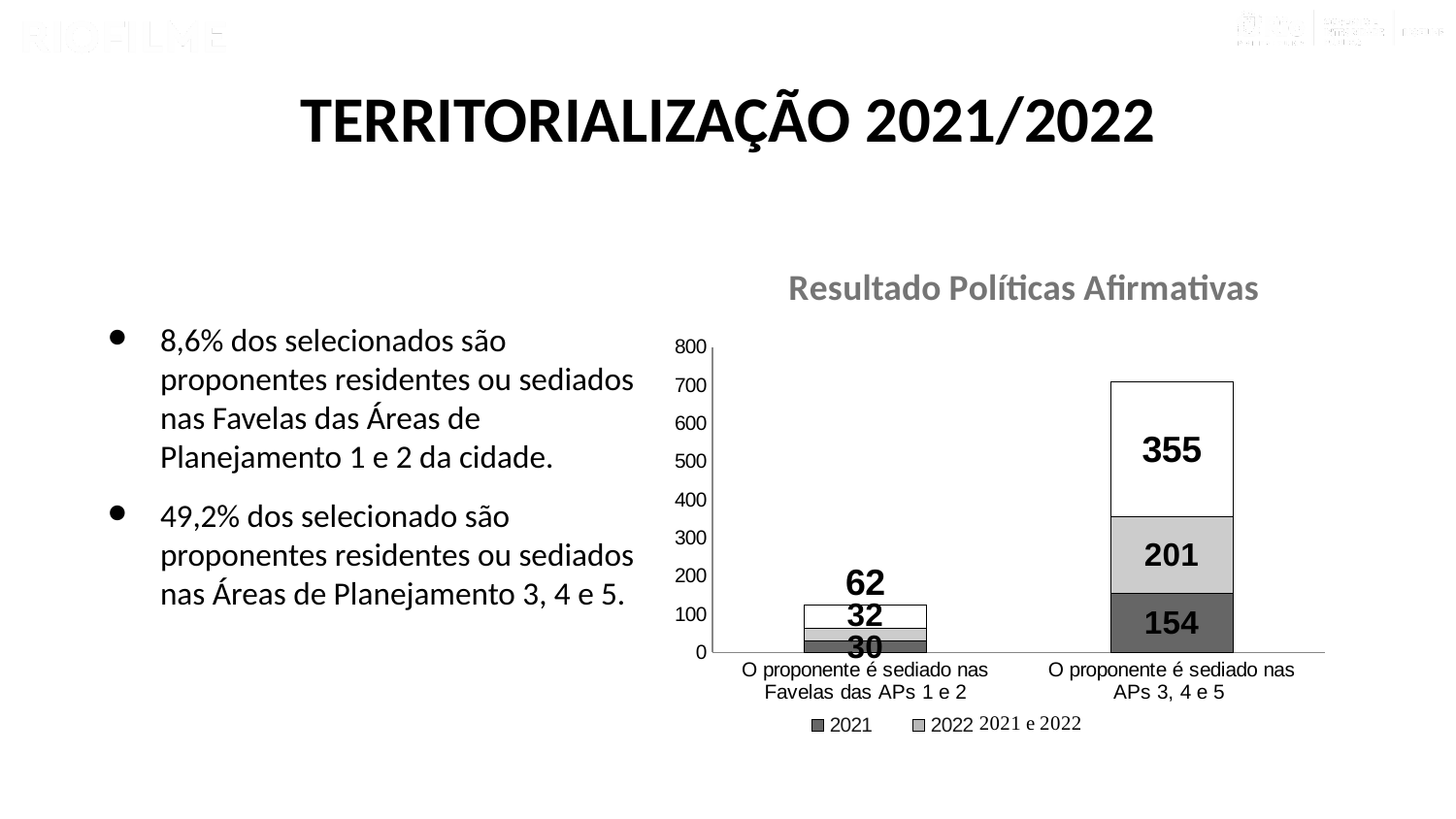
What is the title of the chart? Resultado Políticas Afirmativas What is the total of the stacked bar for 'O proponente é sediado nas APs 3, 4 e 5'? 710 Which category has the higher 2021 value, 'Favelas das APs 1 e 2' or 'APs 3, 4 e 5'? O proponente é sediado nas APs 3, 4 e 5 Which category has the lowest '2021 e 2022' value? O proponente é sediado nas Favelas das APs 1 e 2 How many categories are shown on the x axis of the chart? 2 What is the 2022 value for 'O proponente é sediado nas Favelas das APs 1 e 2'? 32 What kind of chart is shown on the slide? stacked bar chart What is the 2021 value for 'O proponente é sediado nas APs 3, 4 e 5'? 154 What is the total of the stacked bar for 'O proponente é sediado nas Favelas das APs 1 e 2'? 124 What is the difference between the 2022 values for 'APs 3, 4 e 5' and 'Favelas das APs 1 e 2'? 169 What is the '2021 e 2022' value for 'O proponente é sediado nas APs 3, 4 e 5'? 355 How many series does the chart legend list? 3